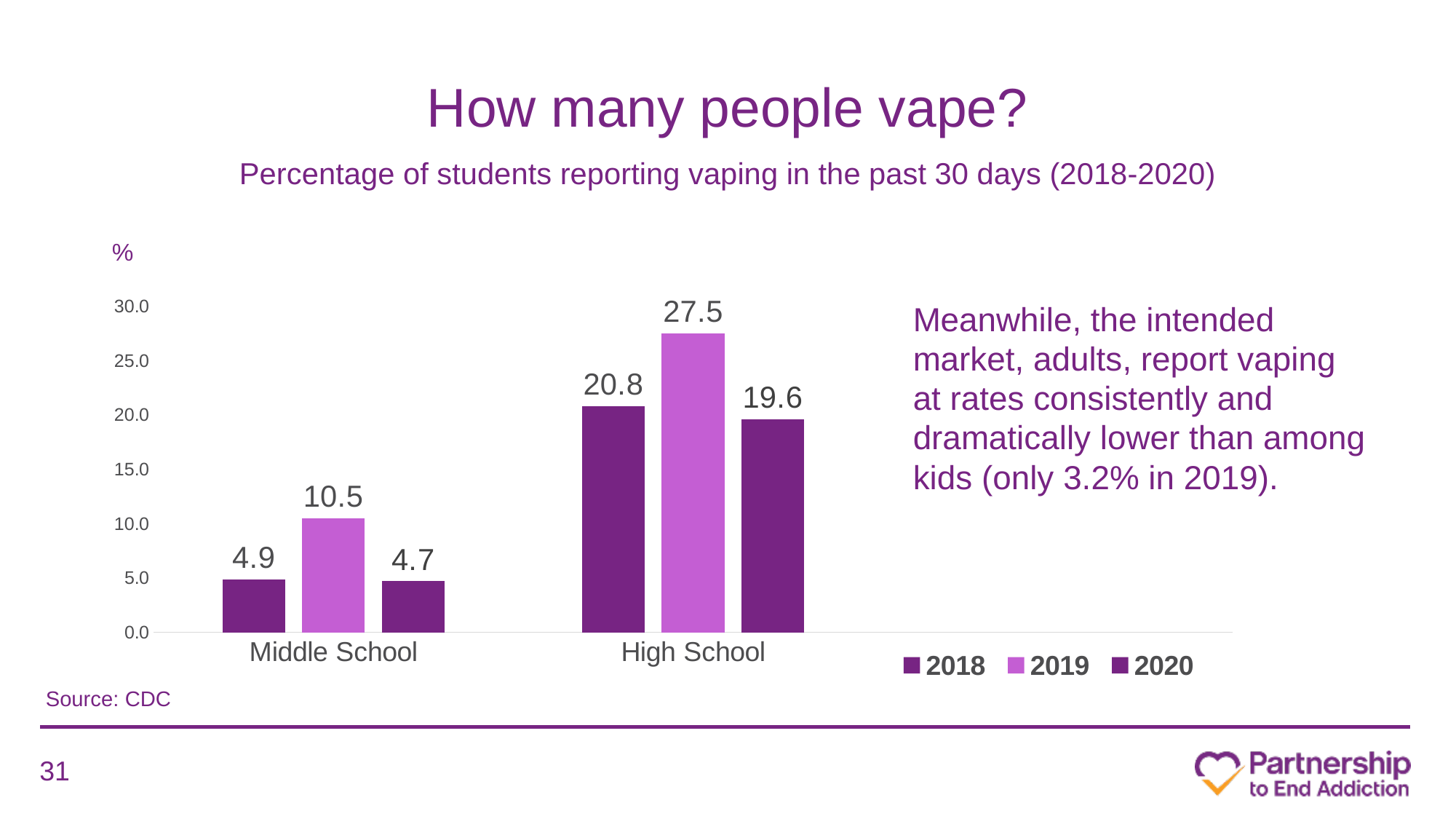
Which year has the highest value for high school students? 2019 What is the value for high school students in 2018? 20.8 What is the difference between the 2019 and 2018 values for middle school students? 5.6 How many categories are shown on the x axis? 2 What percentage of high school students reported vaping in 2020? 19.6 What kind of chart is shown on the slide? Bar chart What percentage of middle school students reported vaping in 2019? 10.5 Which is larger: the 2018 value for middle school or the 2020 value for high school? 2020 value for high school What is the difference between the 2019 and 2020 values for high school students? 7.9 What is the source cited for the chart? CDC How many series does the legend list? 3 Which year has the lowest value for middle school students? 2020